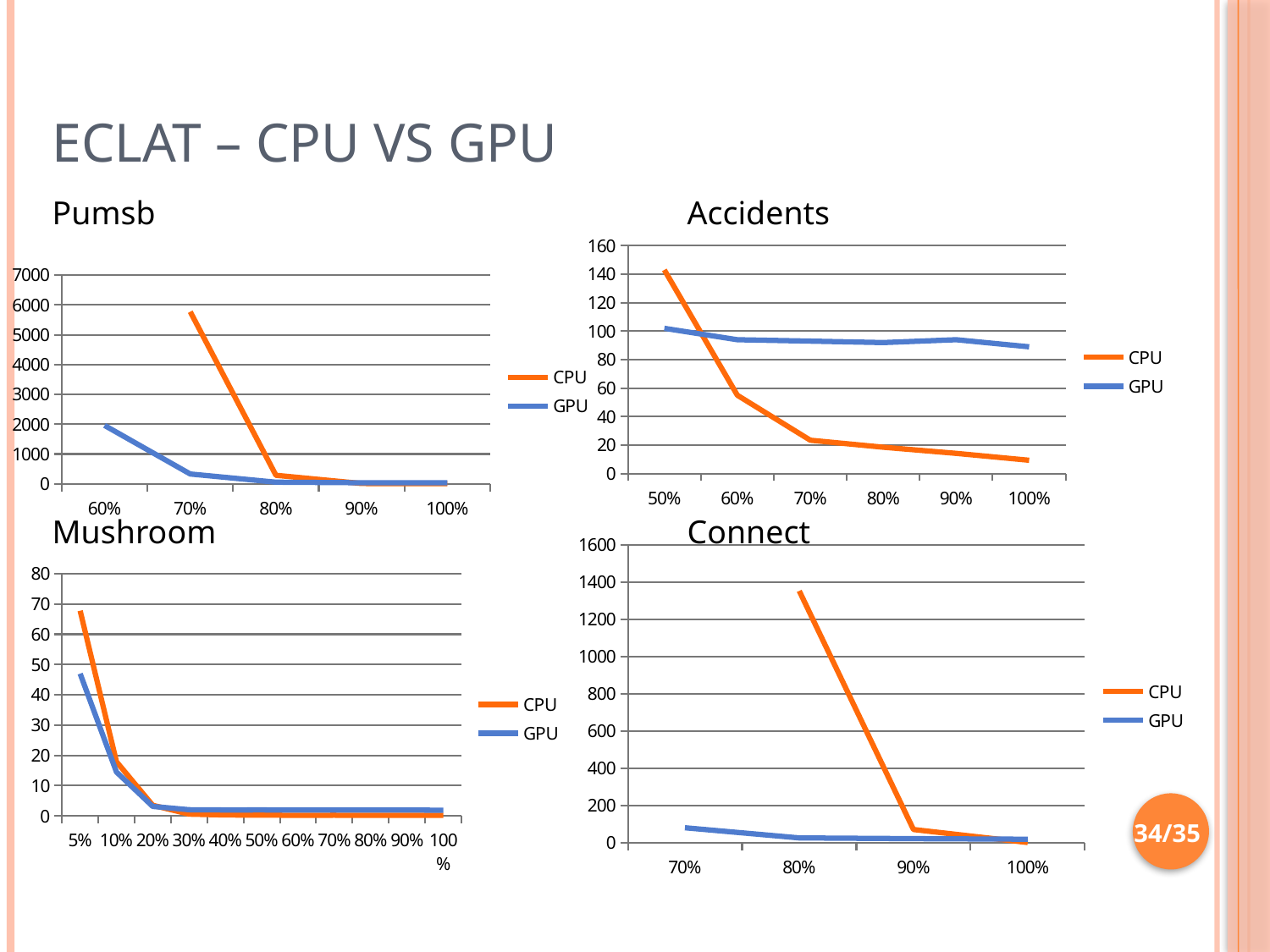
In the Accidents chart, which series has the larger value at 100%, CPU or GPU? GPU In the Accidents chart, is the CPU value at 100% greater or less than 20? less In the Accidents chart, is the CPU value at 50% greater or less than 120? greater In the Accidents chart, does the CPU line rise or fall from 50% to 100%? fall In the Pumsb chart, is the CPU value at 70% greater or less than 5000? greater How many points are plotted along the x axis of the Connect chart? 4 What kind of chart is the Pumsb chart? line chart In the Connect chart, which series has the larger value at 80%, CPU or GPU? CPU How many categories are shown on the x axis of the Mushroom chart? 11 How many series does the legend of the Accidents chart list? 2